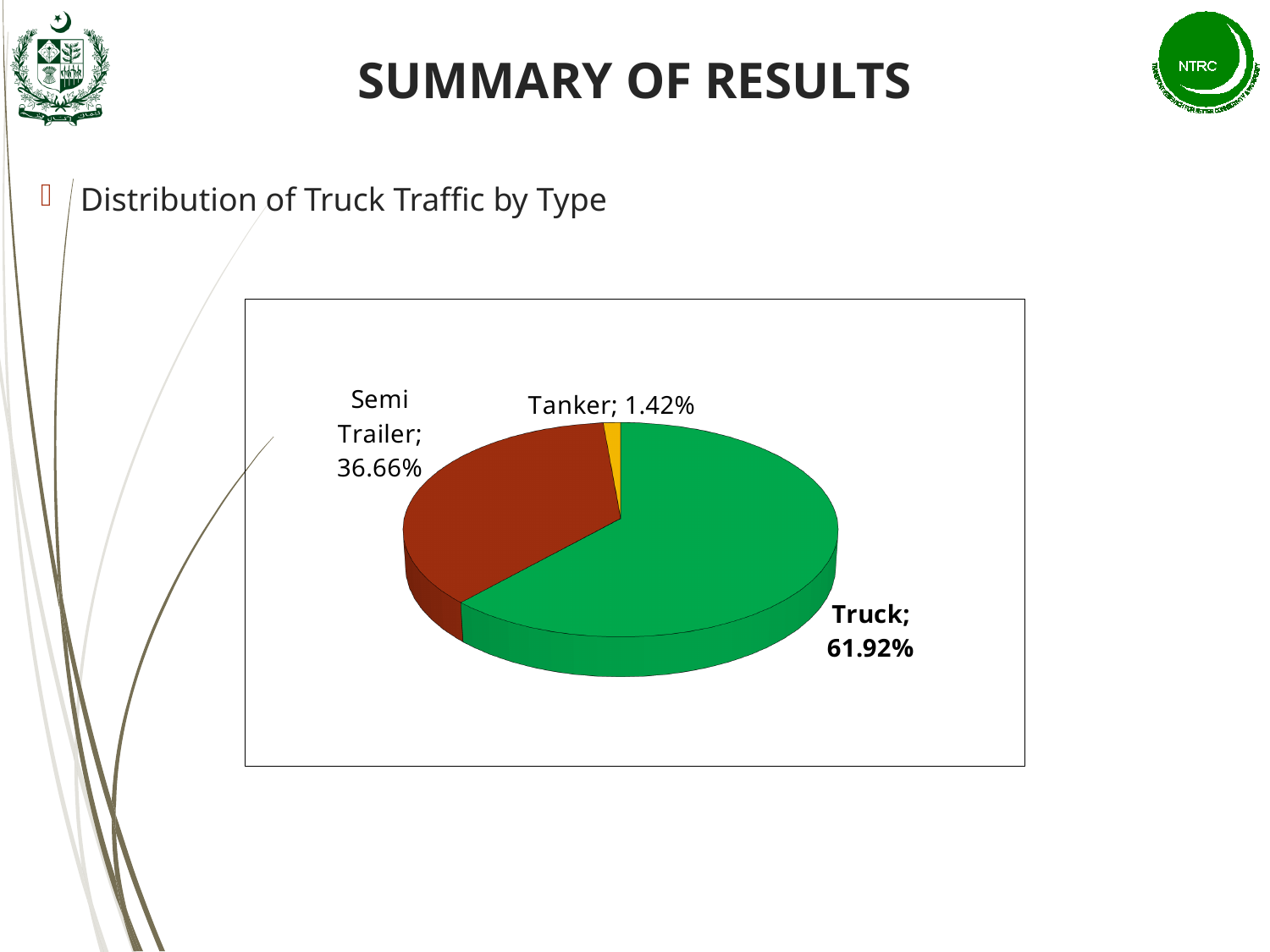
Which truck type has the largest share of traffic? Truck What share of truck traffic is Semi Trailer? 36.66% What is the difference in share between Truck and Semi Trailer? 25.26% What share of truck traffic is Truck? 61.92% What is the heading above the chart describing what it shows? Distribution of Truck Traffic by Type What colour is the Truck slice of the pie chart? Green How many truck types are shown in the pie chart? 3 What share of truck traffic is Tanker? 1.42% What kind of chart is shown on the slide? Pie chart Which has a larger share, Semi Trailer or Tanker? Semi Trailer What is the difference in share between Semi Trailer and Tanker? 35.24% Which truck type has the smallest share of traffic? Tanker